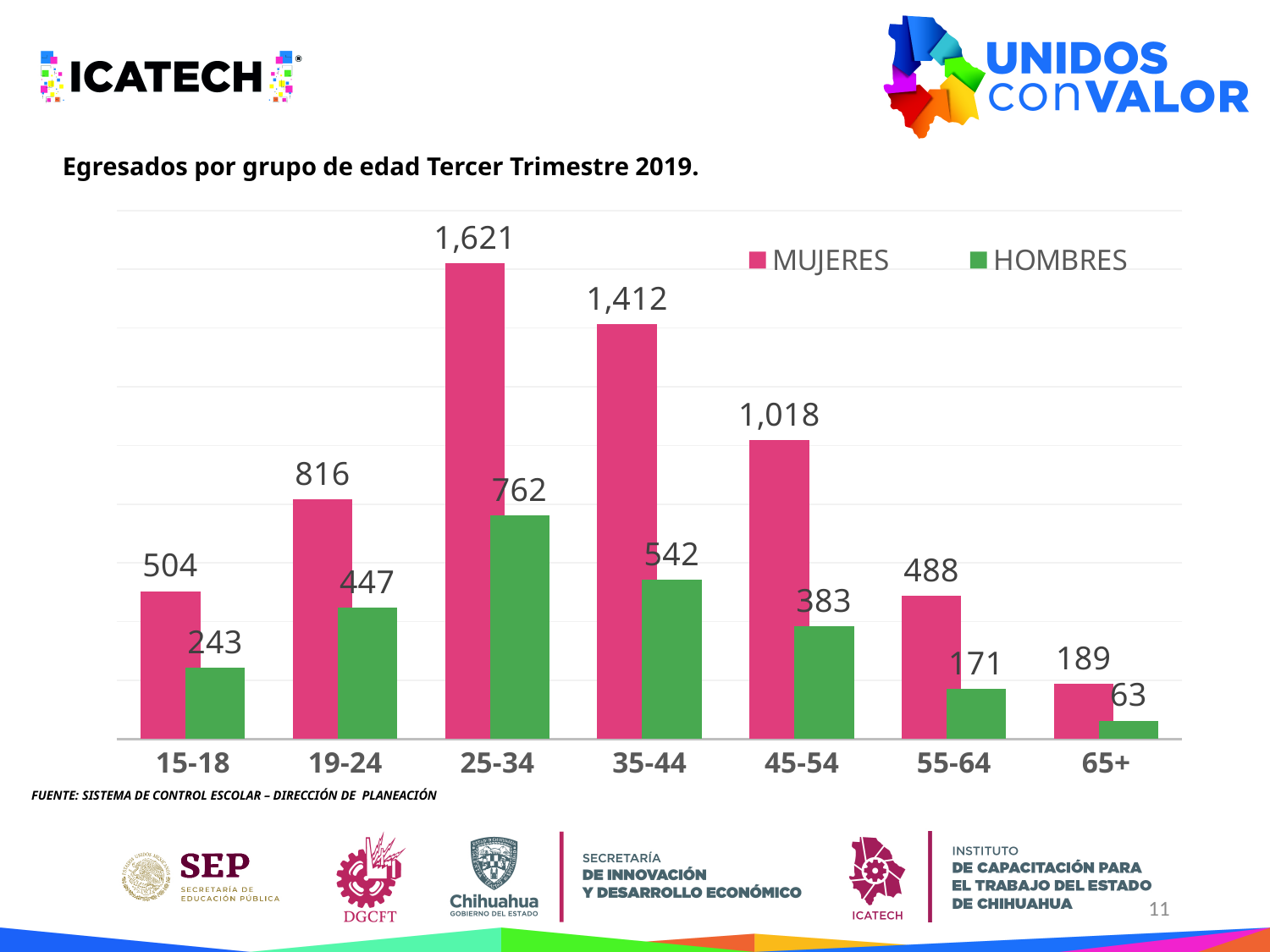
What kind of chart is shown on the slide? Bar chart Which age group has the highest HOMBRES value? 25-34 What is the MUJERES value for the 65+ age group? 189 Do the MUJERES values rise or fall from the 25-34 age group to the 65+ age group? Fall Which age group has the lowest MUJERES value? 65+ What is the difference between the MUJERES and HOMBRES values for the 35-44 age group? 870 What colour represents the HOMBRES series? Green How many age groups are shown on the x axis? 7 What is the MUJERES value for the 25-34 age group? 1,621 Which is larger, the HOMBRES value for 19-24 or the HOMBRES value for 55-64? 19-24 How many series does the legend list? 2 What is the HOMBRES value for the 45-54 age group? 383